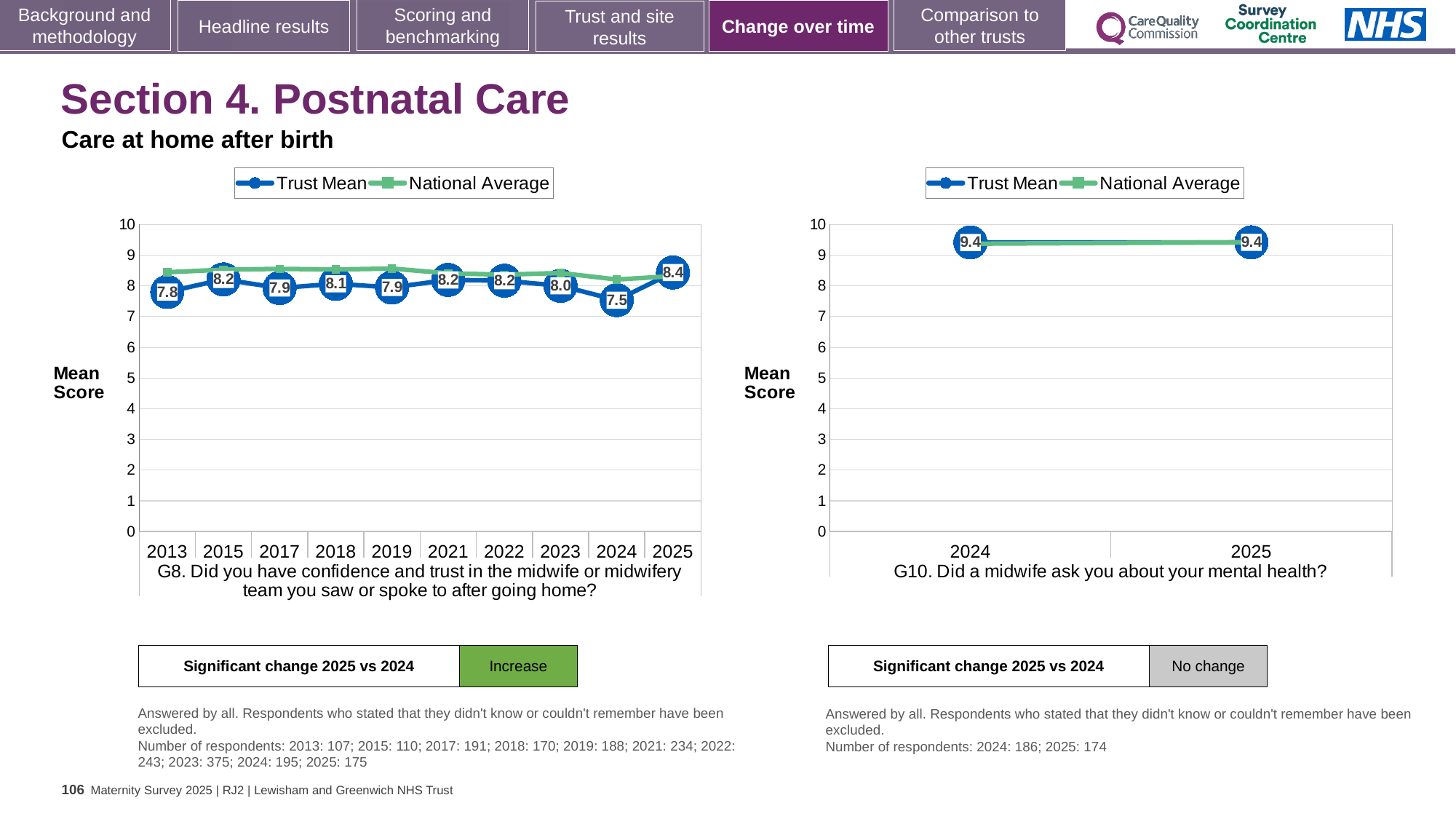
In the G8 chart on the left, what is the Trust Mean score for 2013? 7.8 In the G8 chart on the left, which year has the lowest Trust Mean score? 2024 What kind of chart is the G10 chart on the right? Line chart In the G10 chart on the right, does the Trust Mean score rise, fall or stay the same from 2024 to 2025? Stays the same How many years are plotted on the x axis of the G8 chart on the left? 10 In the G8 chart on the left, is the National Average value for 2013 greater or less than 8? greater What is the y-axis label on the G8 chart on the left? Mean Score In the G8 chart on the left, is the Trust Mean score higher in 2015 or in 2017? 2015 In the G8 chart on the left, what is the Trust Mean score for 2025? 8.4 How many series does the legend of the G10 chart on the right list? 2 In the G8 chart on the left, which year has the highest Trust Mean score? 2025 In the G8 chart on the left, what is the difference between the Trust Mean scores for 2025 and 2024? 0.9